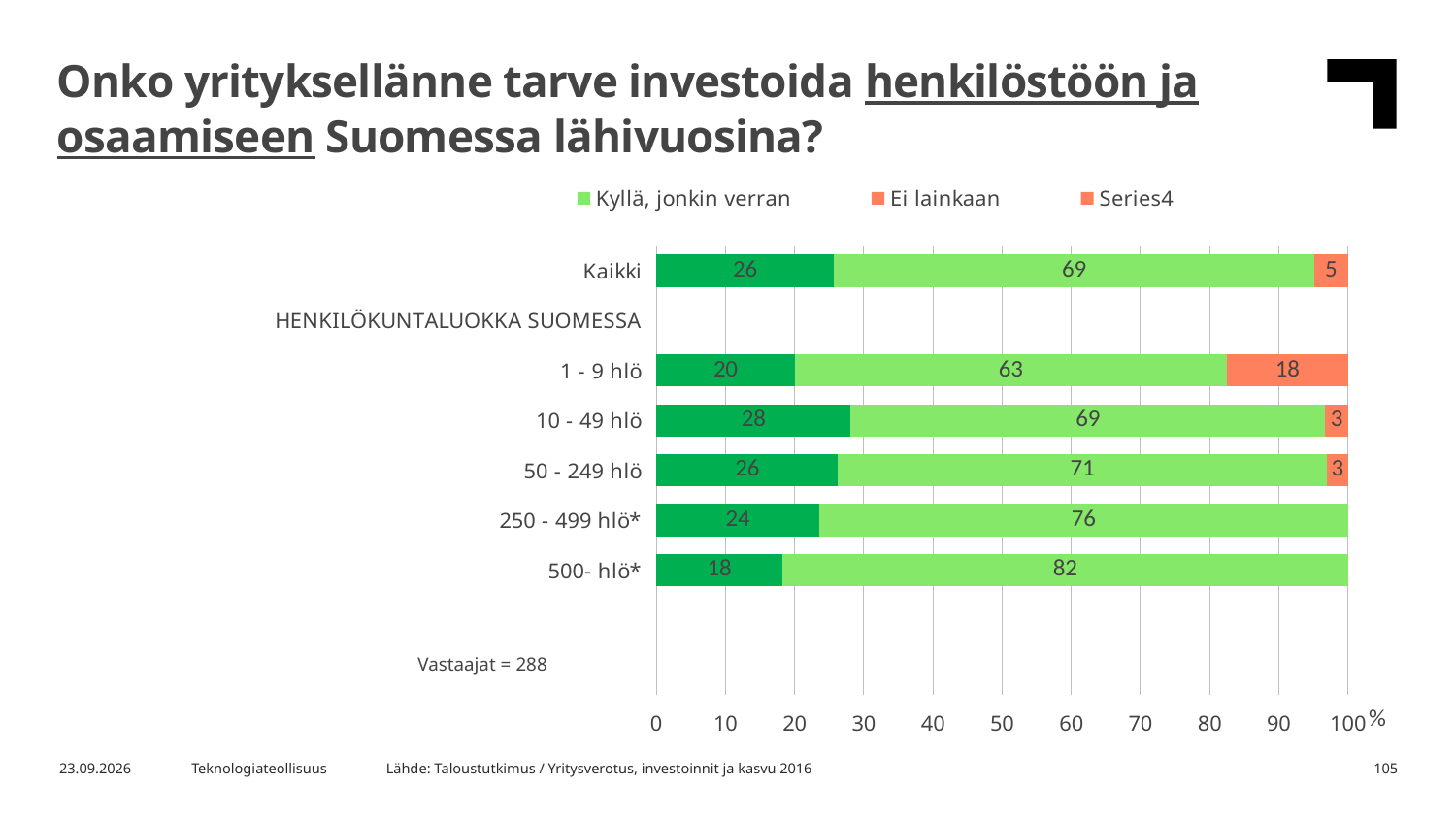
What is the value of the "Ei lainkaan" segment for the "1 - 9 hlö" bar? 18 What is the difference between the "Kyllä, jonkin verran" values for "500- hlö*" and "1 - 9 hlö"? 19 What is the value of the dark green (first) segment for "10 - 49 hlö"? 28 Which category has the lowest "Kyllä, jonkin verran" value? 1 - 9 hlö What is the value of the "Kyllä, jonkin verran" segment for "500- hlö*"? 82 How many bars are plotted in the chart? 6 What is the value of the "Kyllä, jonkin verran" segment for the "Kaikki" bar? 69 Which is larger: the "Kyllä, jonkin verran" value for "250 - 499 hlö*" or for "50 - 249 hlö"? 250 - 499 hlö* How many series does the legend list? 3 What is the total of the "Kaikki" stacked bar? 100 Which category has the highest "Ei lainkaan" value? 1 - 9 hlö What kind of chart is shown on the slide? Stacked bar chart